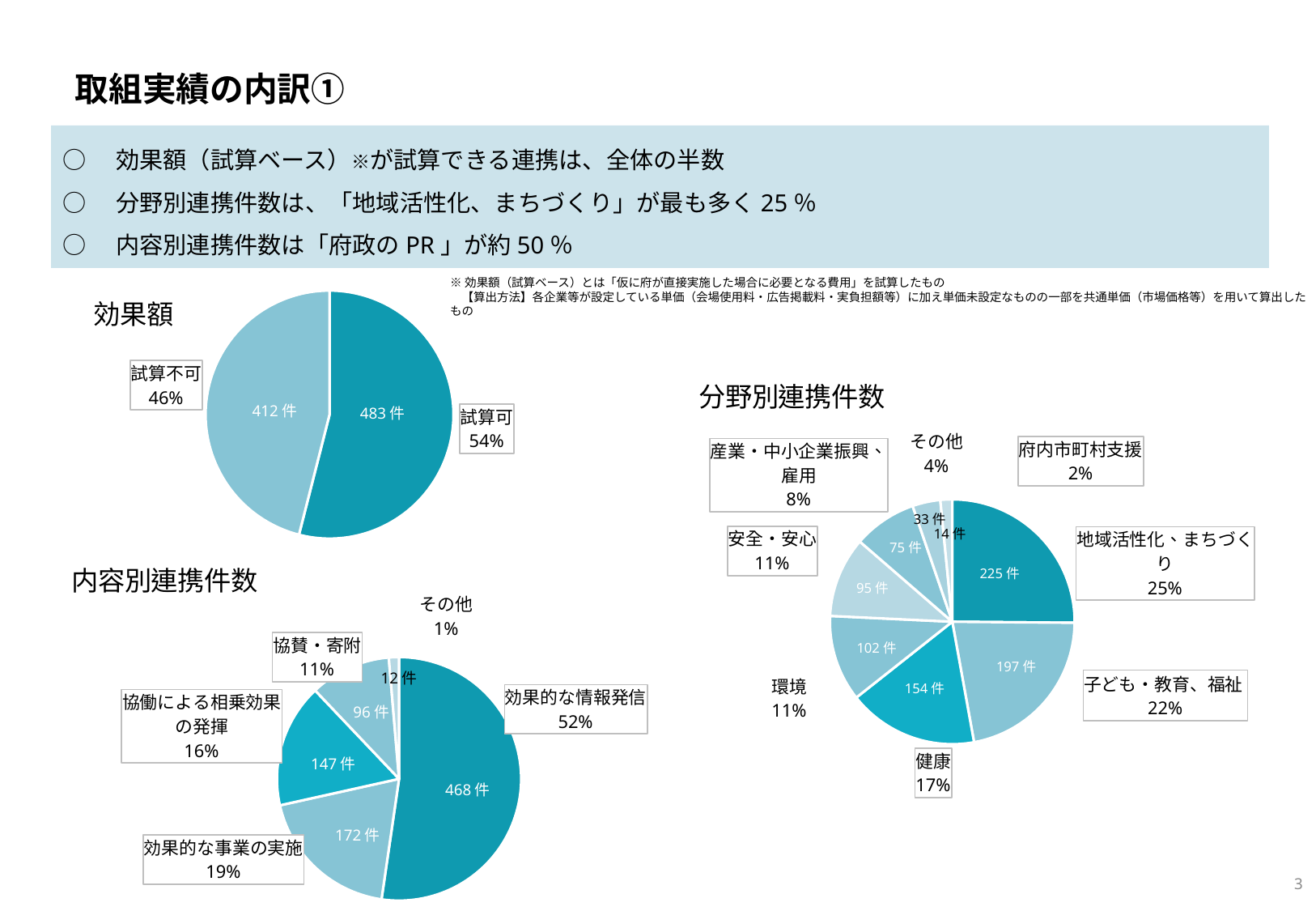
In the 効果額 chart, what share of the pie does 試算不可 represent? 46% In the 分野別連携件数 chart, which is larger, 子ども・教育、福祉 or 環境? 子ども・教育、福祉 In the 内容別連携件数 chart, how many 件 are in the 協働による相乗効果の発揮 slice? 147 件 In the 効果額 chart, how many 件 are in the 試算可 slice? 483 件 In the 内容別連携件数 chart, what share does 効果的な事業の実施 represent? 19% In the 分野別連携件数 chart, how many categories are shown? 8 In the 分野別連携件数 chart, which category has the smallest slice? 府内市町村支援 In the 内容別連携件数 chart, which category has the largest slice? 効果的な情報発信 In the 効果額 chart, what is the difference in 件 between 試算可 and 試算不可? 71 件 In the 分野別連携件数 chart, how many 件 are in the 健康 slice? 154 件 What kind of chart is the 内容別連携件数 chart? pie chart In the 内容別連携件数 chart, how many categories are shown? 5